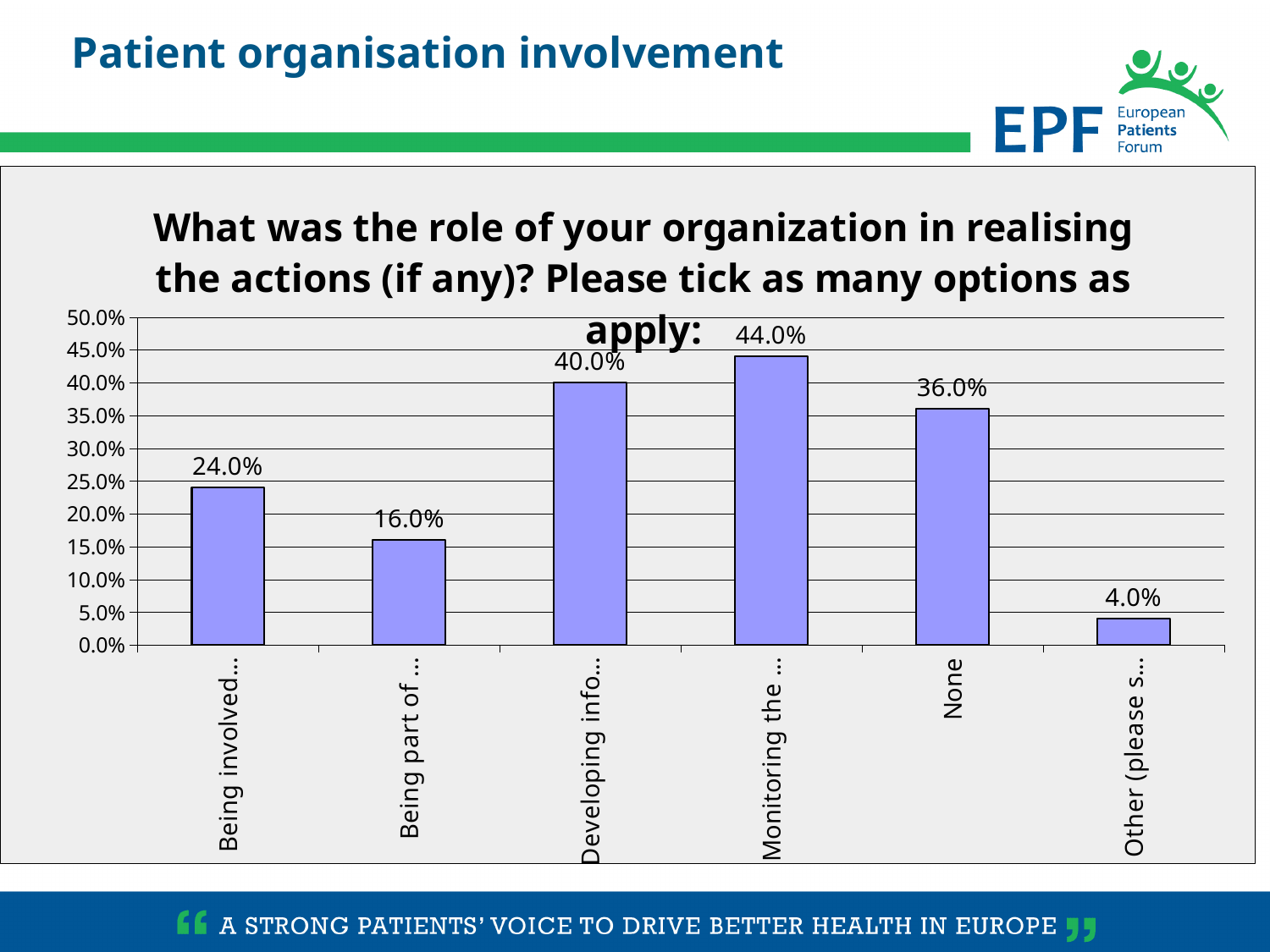
Which is larger, the value for "None" or the value for "Being involved..."? None Which category has the lowest value? Other (please s... What kind of chart is shown on the slide? Bar chart What value is shown for the "None" category? 36.0% What is the highest value shown on the vertical axis? 50.0% How many bars are shown in the chart? 6 What is the difference between the values for "Monitoring the ..." and "Developing info..."? 4.0% What value is shown for the bar labelled "Other (please s..."? 4.0% What value is shown for the bar labelled "Monitoring the ..."? 44.0% Which category has the highest value? Monitoring the ... What value is shown for the bar labelled "Being involved..."? 24.0% What is the difference between the values for "None" and "Being part of ..."? 20.0%